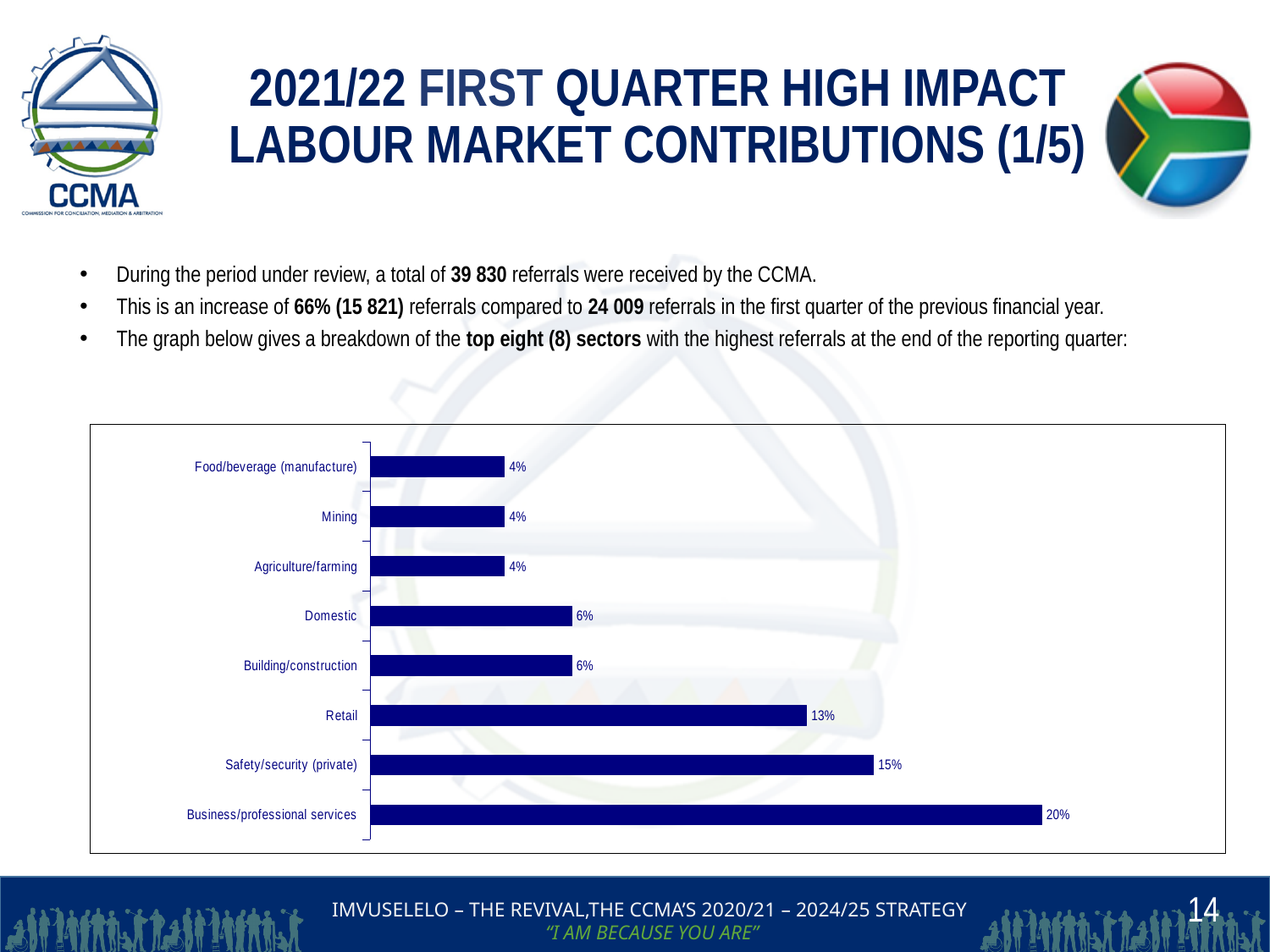
What is the value for Business/professional services? 20% What kind of chart is shown on the slide? Bar chart What is the value for Safety/security (private)? 15% What is the value for Retail? 13% What is the difference between Retail and Domestic? 7% Which is larger, Safety/security (private) or Retail? Safety/security (private) What is the value for Domestic? 6% How many sectors are shown in the chart? 8 What is the difference between Business/professional services and Safety/security (private)? 5% What is the value for Mining? 4% Which is larger, Retail or Building/construction? Retail Which sector has the highest value? Business/professional services